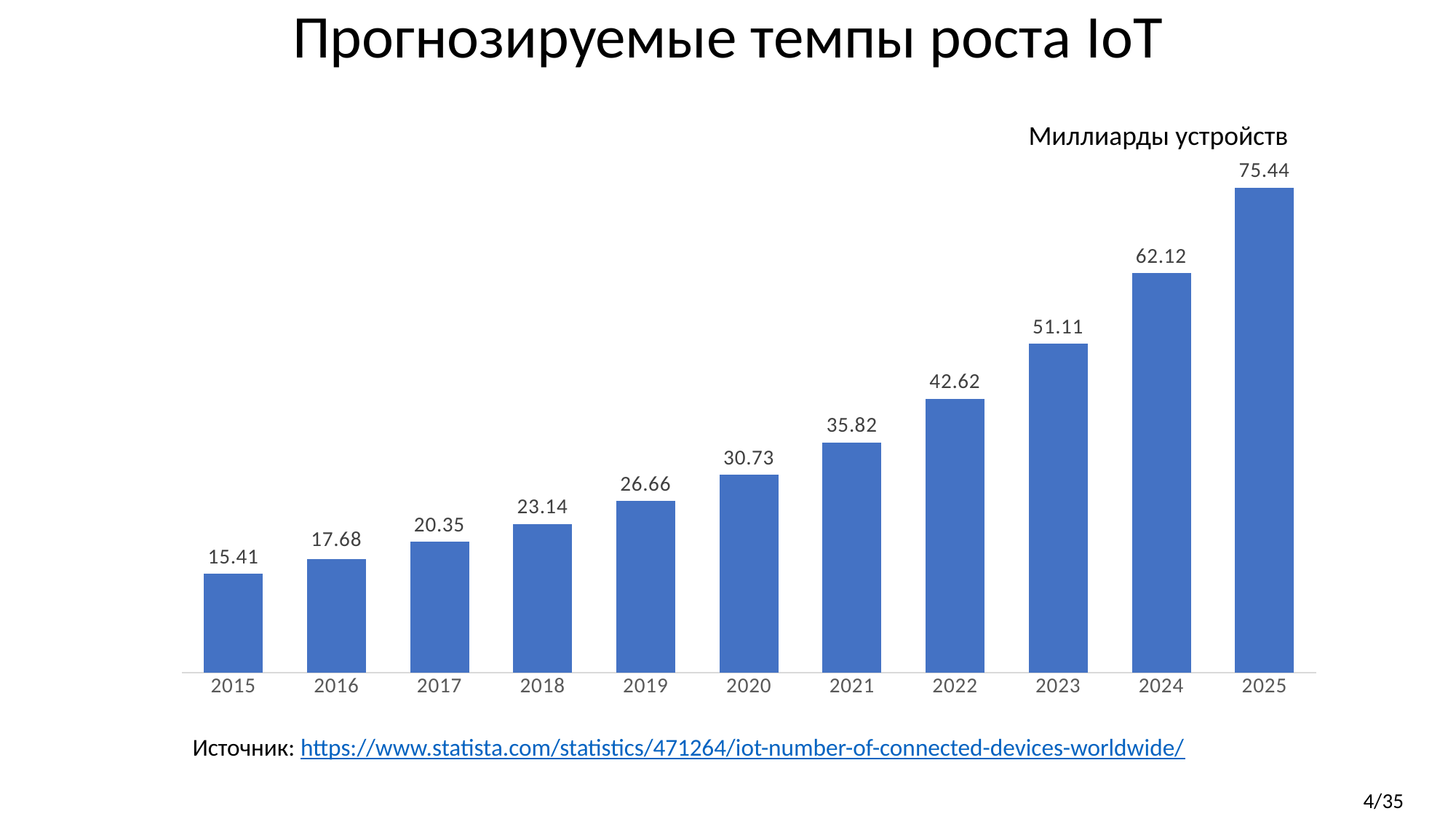
What is the difference between the values for 2019 and 2018? 3.52 Which year has the lowest value? 2015 What is the title of the slide? Прогнозируемые темпы роста IoT Which is larger, the value for 2021 or the value for 2022? 2022 Do the values rise or fall from 2015 to 2025? rise What is the value for 2023? 51.11 What is the value for 2020? 30.73 What kind of chart is this? bar chart How many years are shown on the x axis? 11 What is the difference between the values for 2025 and 2024? 13.32 Which year has the highest value? 2025 What is the value for 2015? 15.41